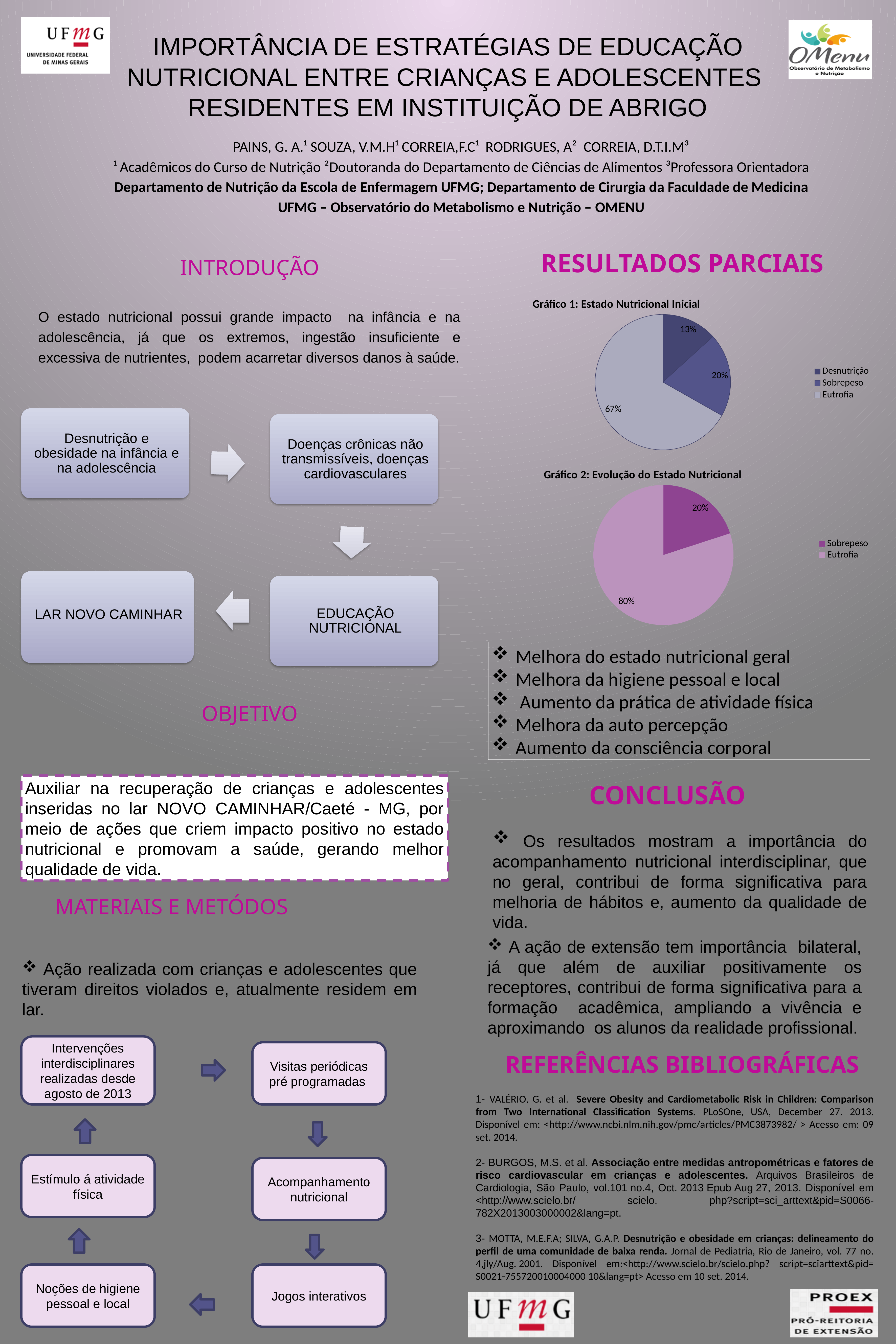
In the chart titled 'Gráfico 2: Evolução do Estado Nutricional', what percentage is shown for Eutrofia? 80% In the chart titled 'Gráfico 1: Estado Nutricional Inicial', what percentage is shown for Sobrepeso? 20% In the chart titled 'Gráfico 2: Evolução do Estado Nutricional', which is larger, Sobrepeso or Eutrofia? Eutrofia What type of chart is 'Gráfico 2: Evolução do Estado Nutricional'? Pie chart In the chart titled 'Gráfico 1: Estado Nutricional Inicial', which category has the smallest slice? Desnutrição In the chart titled 'Gráfico 2: Evolução do Estado Nutricional', how many categories does the legend list? 2 In the chart titled 'Gráfico 2: Evolução do Estado Nutricional', what percentage is shown for Sobrepeso? 20% In the chart titled 'Gráfico 1: Estado Nutricional Inicial', what percentage is shown for Desnutrição? 13% In the chart titled 'Gráfico 1: Estado Nutricional Inicial', how many categories does the legend list? 3 In the chart titled 'Gráfico 1: Estado Nutricional Inicial', what percentage is shown for Eutrofia? 67% In the chart titled 'Gráfico 1: Estado Nutricional Inicial', which category has the largest slice? Eutrofia In the chart titled 'Gráfico 1: Estado Nutricional Inicial', what is the difference in percentage points between Eutrofia and Sobrepeso? 47